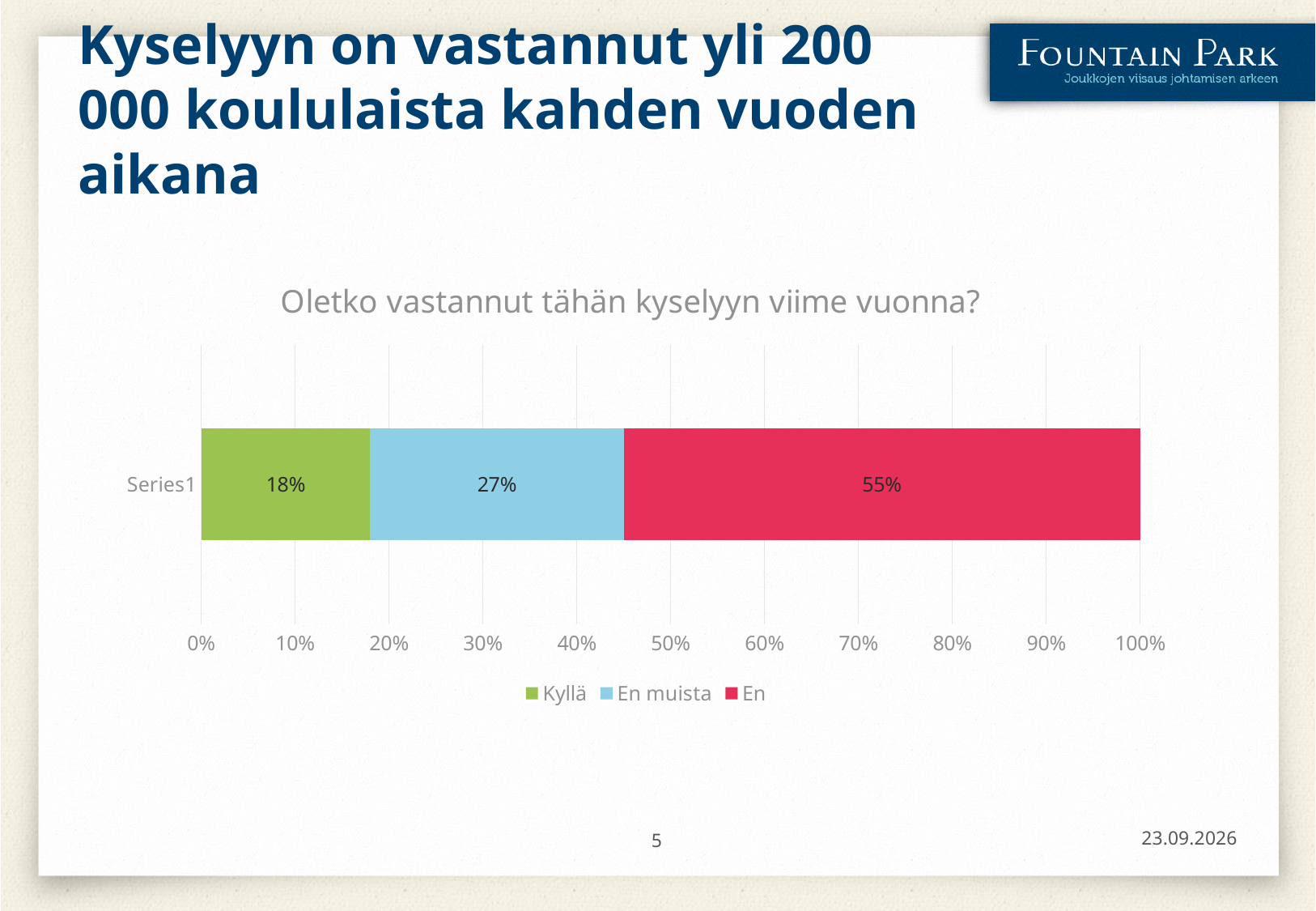
What is the title of the chart? Oletko vastannut tähän kyselyyn viime vuonna? What kind of chart is shown on the slide? Stacked bar chart What is the value for "En muista" in the chart? 27% Which legend entry has the lowest value in the chart? Kyllä What is the difference between the values for "En" and "Kyllä"? 37% How many series does the legend list? 3 Which is larger, the value for "En muista" or the value for "Kyllä"? En muista What is the total of the stacked bar? 100% What is the value for "Kyllä" in the chart? 18% What is the value for "En" in the chart? 55% Which legend entry has the highest value in the chart? En Is the value for "En" greater or less than 50%? greater